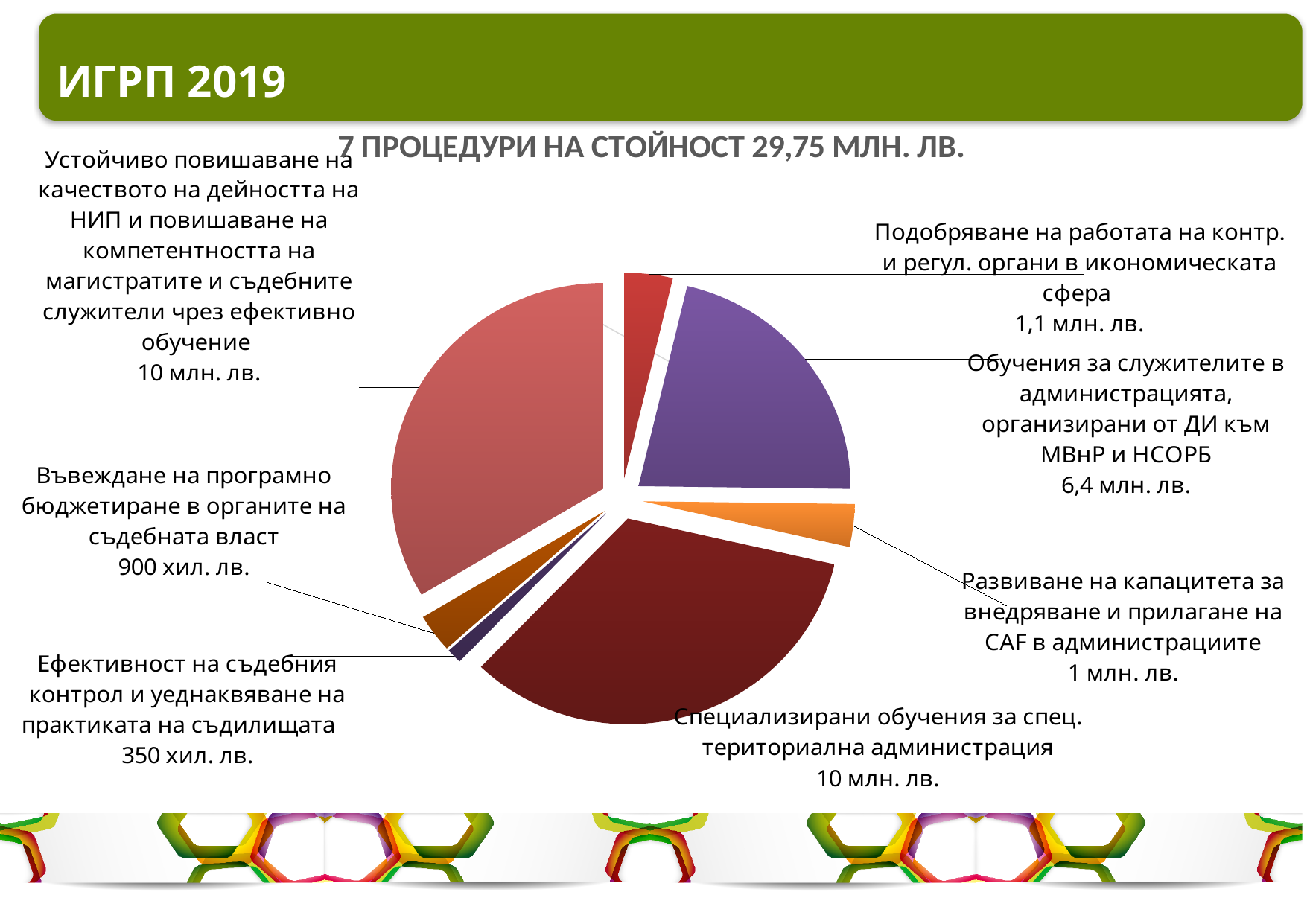
What is the difference between the value for "Въвеждане на програмно бюджетиране" (900 хил. лв.) and the value for "Ефективност на съдебния контрол" (350 хил. лв.)? 550 хил. лв. What is the difference between the value for "Устойчиво повишаване на качеството на дейността на НИП" (10 млн. лв.) and the value for "Обучения за служителите в администрацията" (6,4 млн. лв.)? 3,6 млн. лв. What total value of the 7 procedures is stated in the chart title? 29,75 млн. лв. What kind of chart is shown on the slide? Pie chart Which is larger: the value for "Обучения за служителите в администрацията" or the value for "Подобряване на работата на контр. и регул. органи"? Обучения за служителите в администрацията (6,4 млн. лв.) What is the value for "Въвеждане на програмно бюджетиране в органите на съдебната власт"? 900 хил. лв. Which procedure has the smallest value in the pie chart? Ефективност на съдебния контрол и уеднаквяване на практиката на съдилищата (350 хил. лв.) How many slices does the pie chart have? 7 What is the value for "Обучения за служителите в администрацията, организирани от ДИ към МВнР и НСОРБ"? 6,4 млн. лв. What is the value for "Подобряване на работата на контр. и регул. органи в икономическата сфера"? 1,1 млн. лв. What is the value for "Специализирани обучения за спец. териториална администрация"? 10 млн. лв. What is the value for "Развиване на капацитета за внедряване и прилагане на CAF в администрациите"? 1 млн. лв.